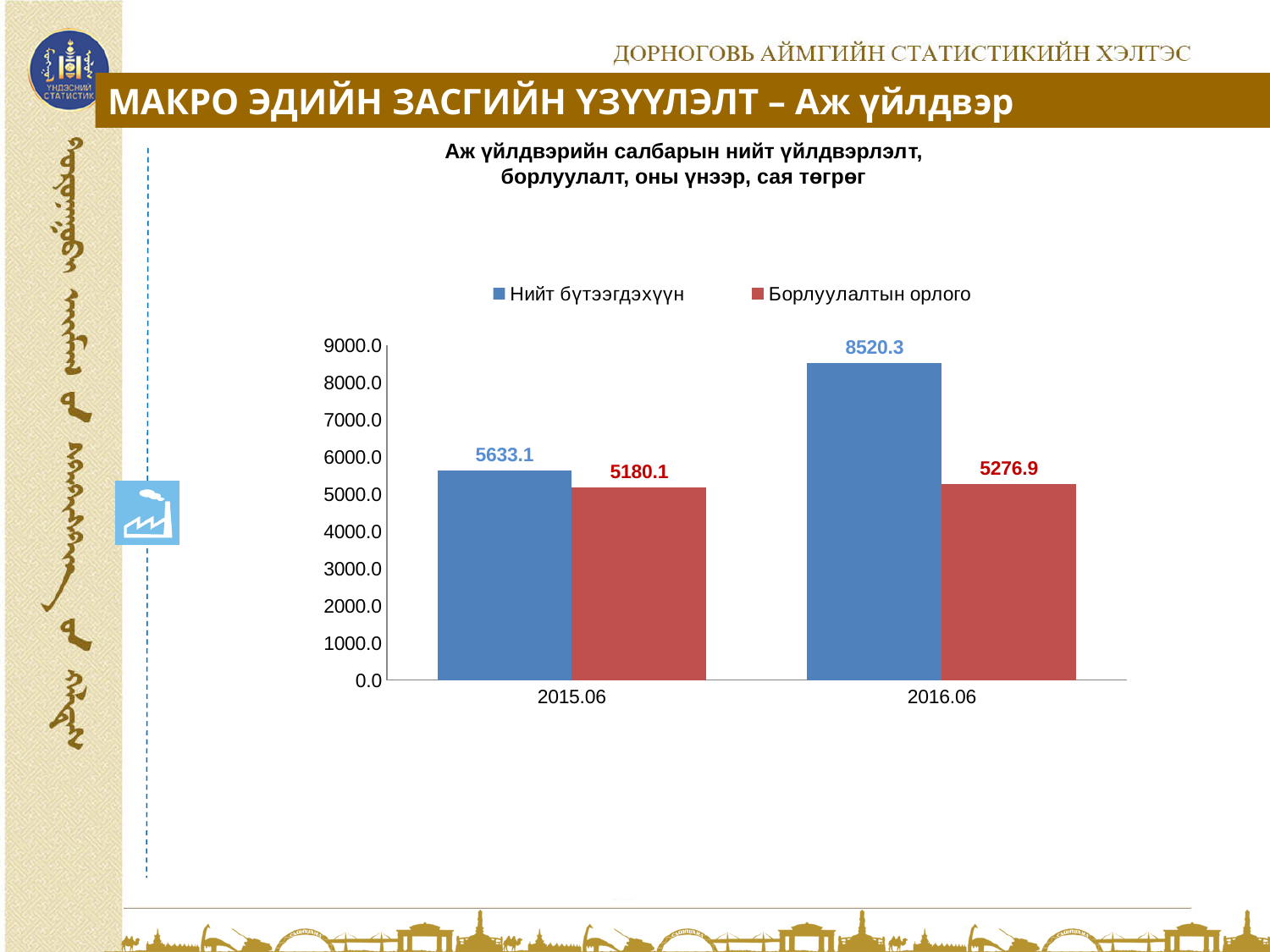
Which bar has the lowest value on the chart? Борлуулалтын орлого for 2015.06 What is the value of Нийт бүтээгдэхүүн for 2015.06? 5633.1 What is the difference between Нийт бүтээгдэхүүн in 2016.06 and in 2015.06? 2887.2 What is the value of Борлуулалтын орлого for 2015.06? 5180.1 Which category has the highest value for Нийт бүтээгдэхүүн? 2016.06 What is the difference between Нийт бүтээгдэхүүн and Борлуулалтын орлого in 2015.06? 453.0 What is the value of Борлуулалтын орлого for 2016.06? 5276.9 What kind of chart is shown on the slide? bar chart Is the value of Нийт бүтээгдэхүүн for 2016.06 greater or less than 8000.0? greater How many categories are shown on the x axis? 2 Which is larger in 2016.06, Нийт бүтээгдэхүүн or Борлуулалтын орлого? Нийт бүтээгдэхүүн How many series does the legend list? 2